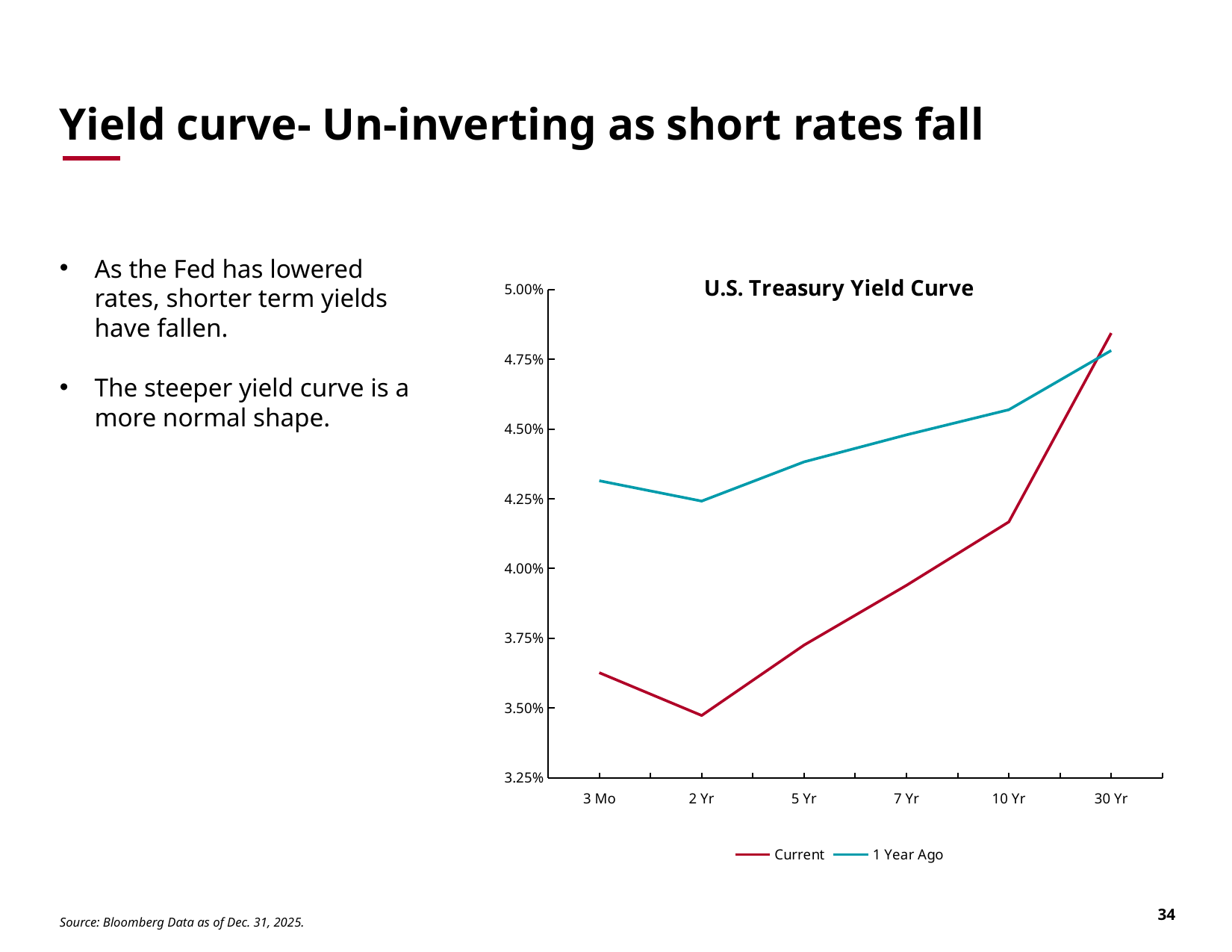
Which maturity has the highest Current yield? 30 Yr Is the 1 Year Ago yield at 10 Yr greater or less than 4.50%? greater Is the Current yield at 2 Yr greater or less than 3.50%? less Which maturity has the lowest Current yield? 2 Yr Does the Current yield rise or fall from 2 Yr to 30 Yr? rise At 30 Yr, which series has the higher yield, Current or 1 Year Ago? Current Is the Current yield at 10 Yr greater or less than 4.00%? greater How many series does the legend of the U.S. Treasury Yield Curve chart list? 2 How many maturities are shown on the x axis of the U.S. Treasury Yield Curve chart? 6 Which maturity has the lowest 1 Year Ago yield? 2 Yr At 10 Yr, which series has the higher yield, Current or 1 Year Ago? 1 Year Ago What kind of chart is the U.S. Treasury Yield Curve chart? line chart